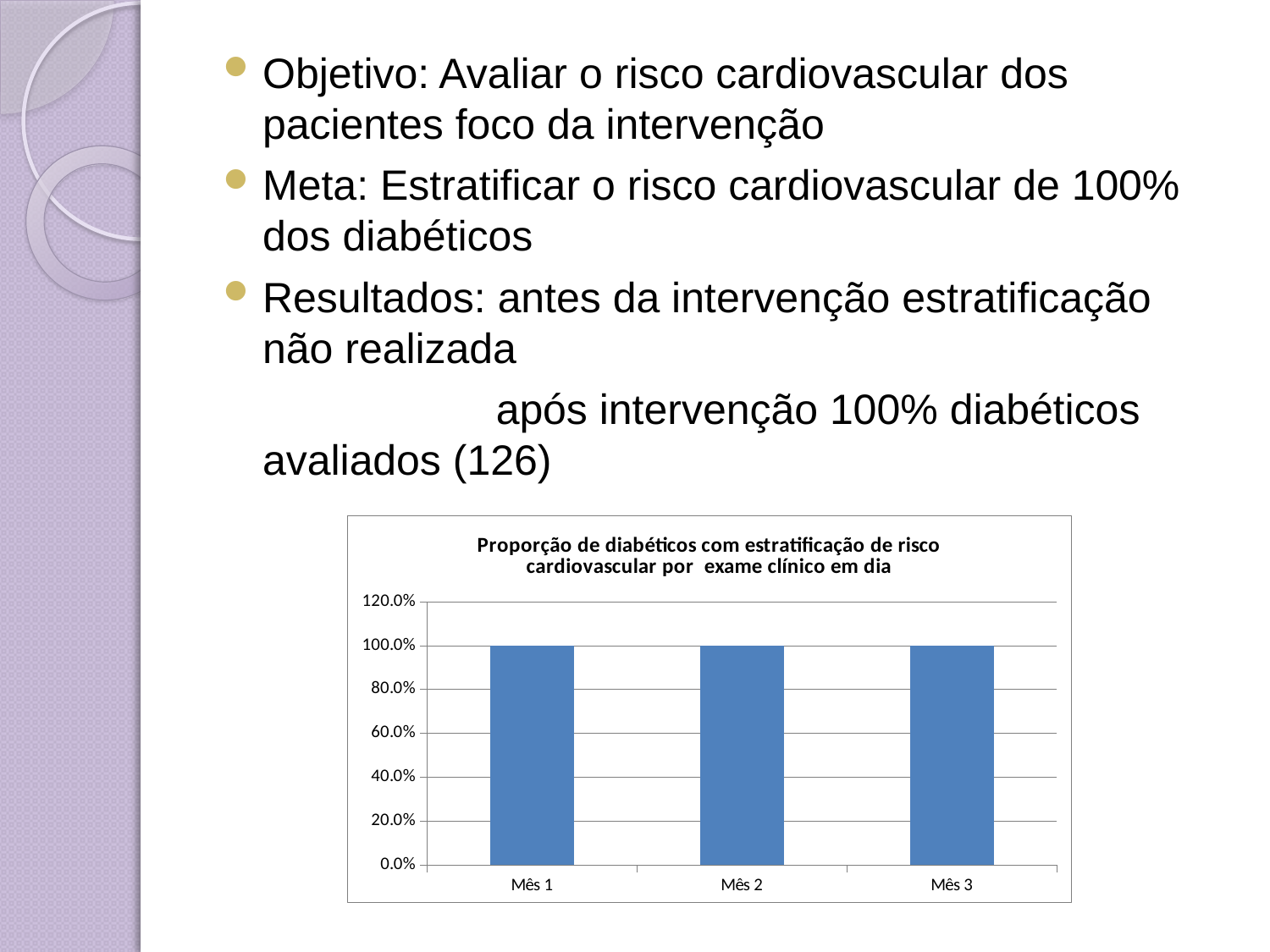
What is the highest value shown on the vertical axis of the chart? 120.0% What type of chart is shown on the slide? bar chart What is the value for Mês 3? 100.0% What is the value for Mês 2? 100.0% Do the values rise, fall, or stay the same from Mês 1 to Mês 3? stay the same How many categories (months) are plotted on the chart? 3 What is the difference between the values for Mês 1 and Mês 3? 0.0% Is the value for Mês 3 greater or less than 120.0%? less What is the title of the chart? Proporção de diabéticos com estratificação de risco cardiovascular por exame clínico em dia Is the value for Mês 2 greater or less than 80.0%? greater What is the value for Mês 1? 100.0%